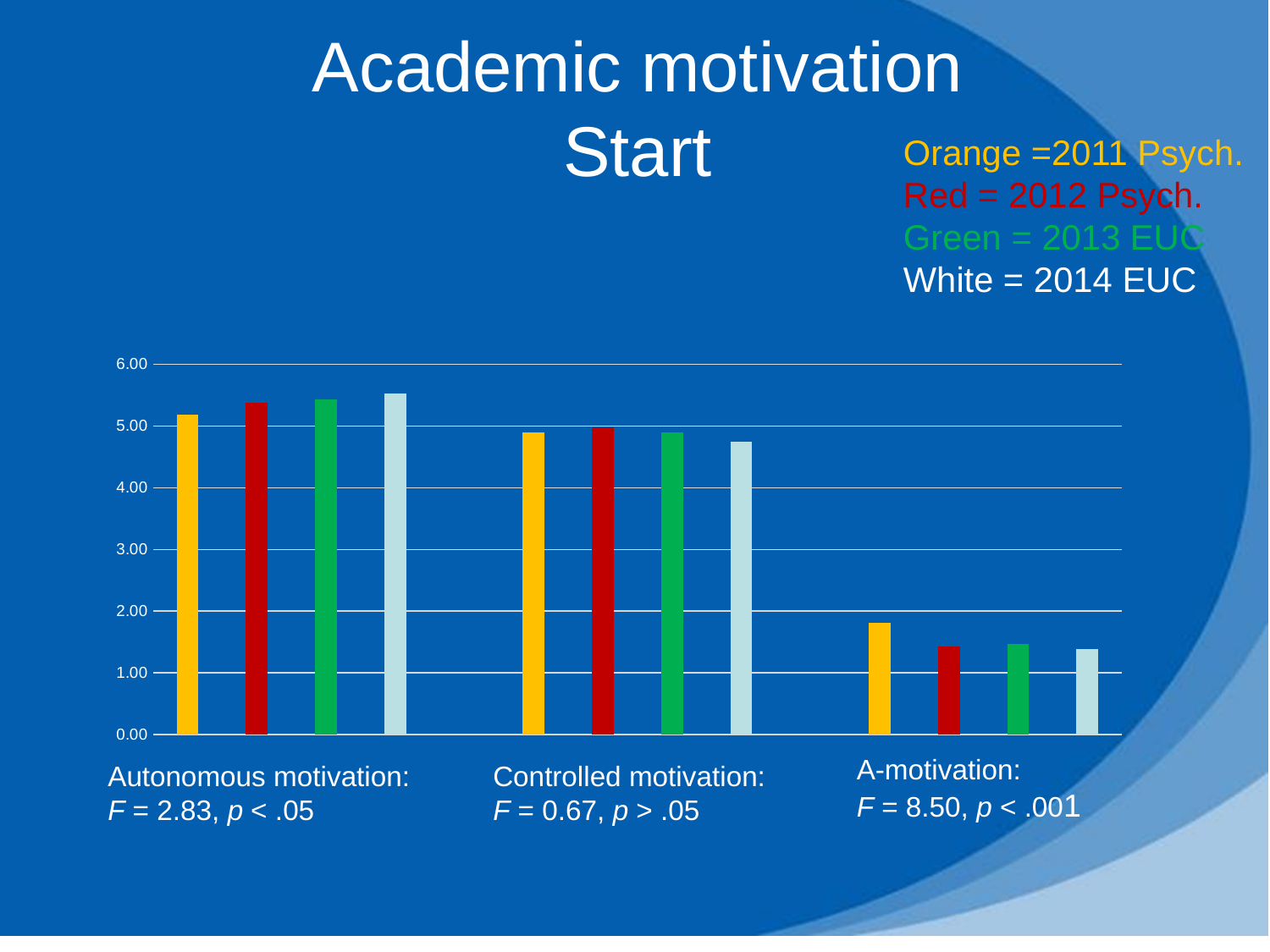
How many series (colours) does the slide's colour key list for the chart? 4 Is the value for A-motivation for 2011 Psych. (orange) greater or less than 2.00? less Is the value for A-motivation for 2012 Psych. (red) greater or less than 1.00? greater Which motivation category has the highest bars overall? Autonomous motivation What kind of chart is shown on the slide? bar chart Which colour represents 2014 EUC in the chart? White Is the value for Controlled motivation for 2014 EUC (white) greater or less than 5.00? less Which motivation category has the lowest bars overall? A-motivation Within the A-motivation category, which series has the highest bar? 2011 Psych. (orange) How many motivation categories are shown along the x axis of the chart? 3 Which year and group does the orange bar represent? 2011 Psych.